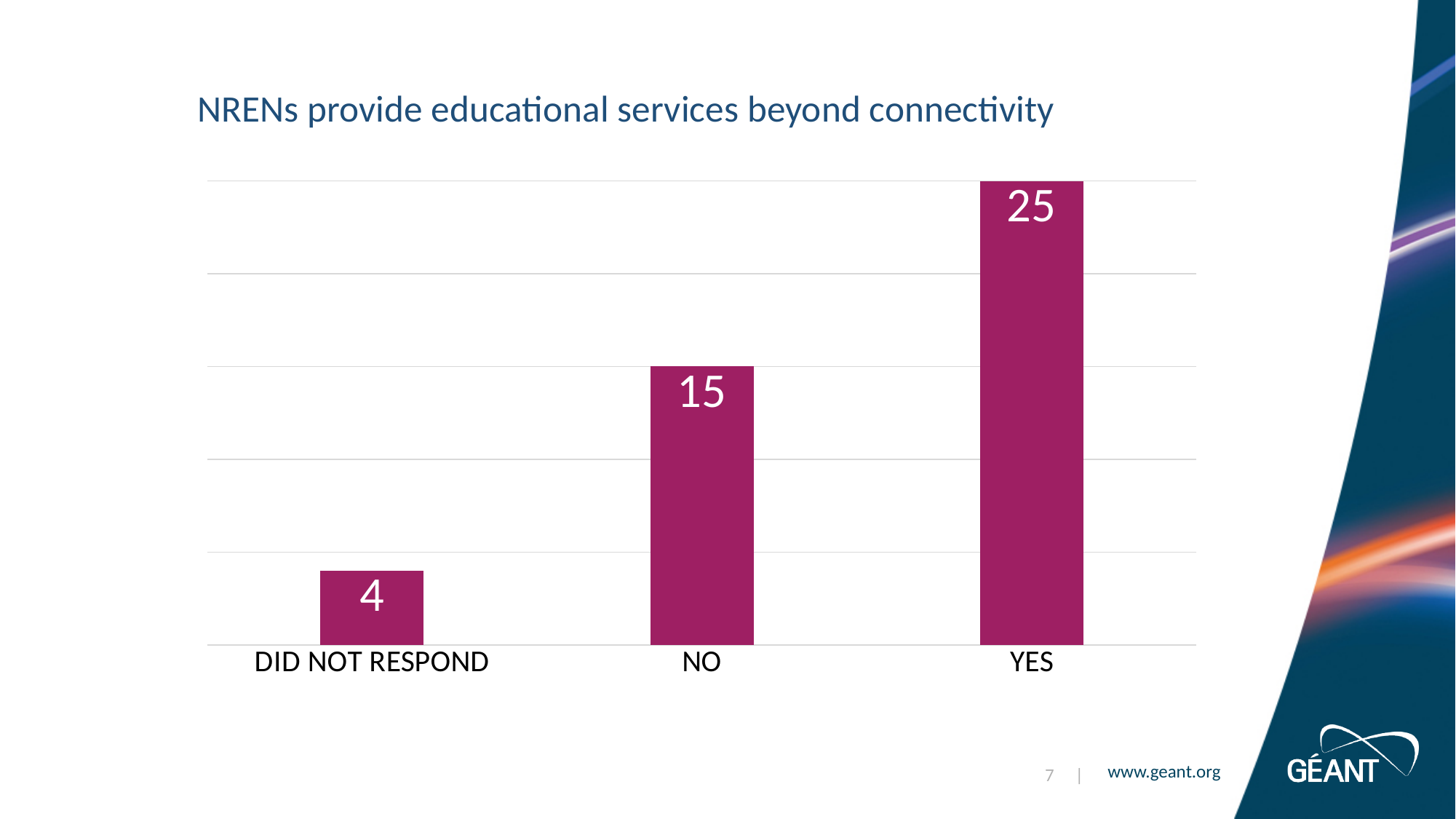
What is the value for NO? 15 What is the difference between the values for NO and DID NOT RESPOND? 11 What is the title of the chart? NRENs provide educational services beyond connectivity Which is larger, the value for NO or the value for DID NOT RESPOND? NO What kind of chart is shown on the slide? bar chart What is the difference between the values for YES and NO? 10 Which category has the lowest value? DID NOT RESPOND What is the value for DID NOT RESPOND? 4 What is the value for YES? 25 What is the total of the three values shown in the chart? 44 Which category has the highest value? YES How many categories are shown on the x axis? 3